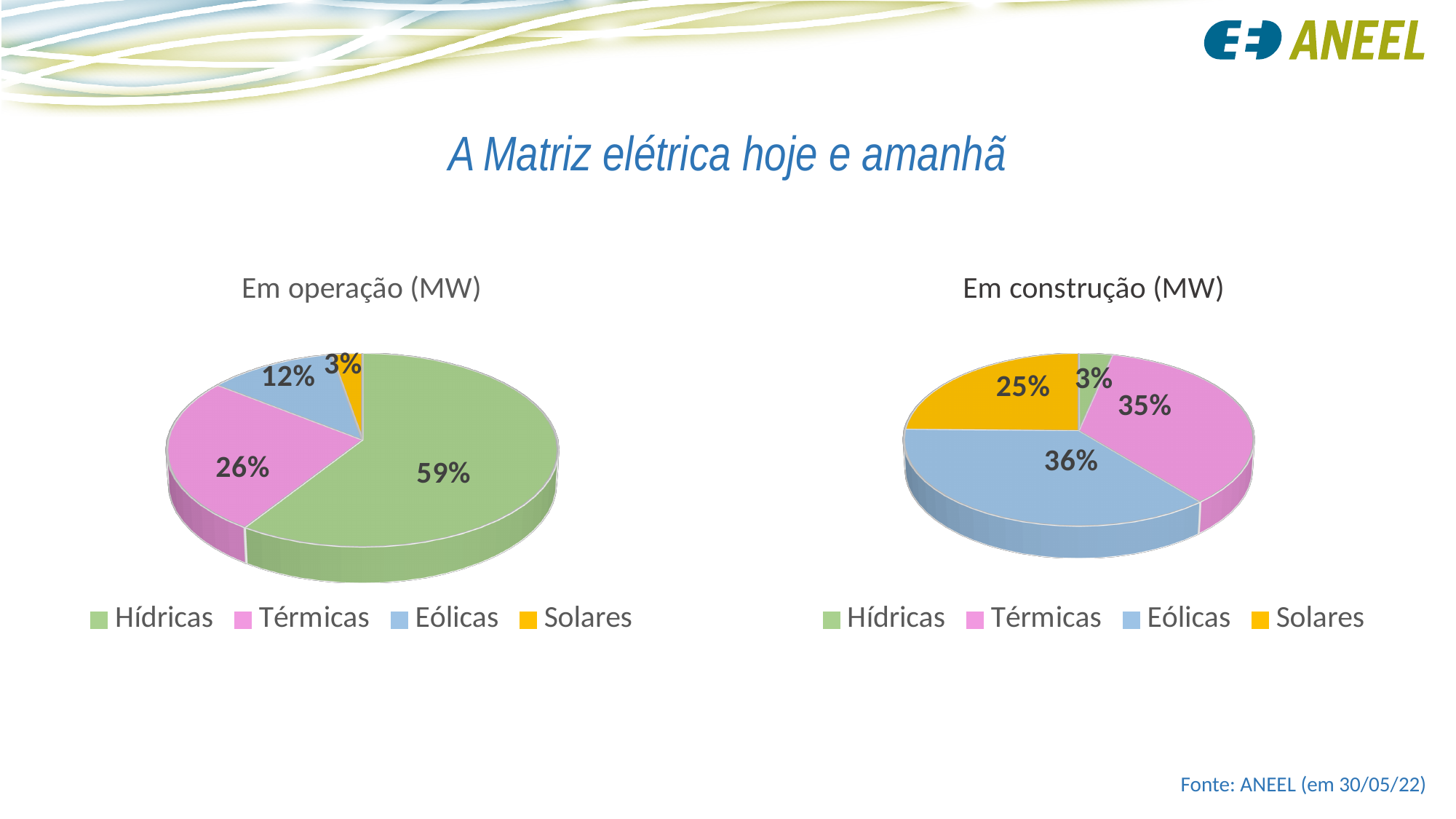
In the 'Em operação (MW)' chart, what share does Térmicas have? 26% In the 'Em operação (MW)' chart, which category has the largest slice? Hídricas In the 'Em construção (MW)' chart, what share does Solares have? 25% In the 'Em construção (MW)' chart, which is larger, Térmicas or Solares? Térmicas In the 'Em construção (MW)' chart, what share does Eólicas have? 36% What kind of chart is the 'Em construção (MW)' chart? Pie chart In the 'Em operação (MW)' chart, what is the difference between the Hídricas and Térmicas shares? 33 percentage points In the 'Em construção (MW)' chart, which category has the smallest slice? Hídricas How many categories does the legend of the 'Em operação (MW)' chart list? 4